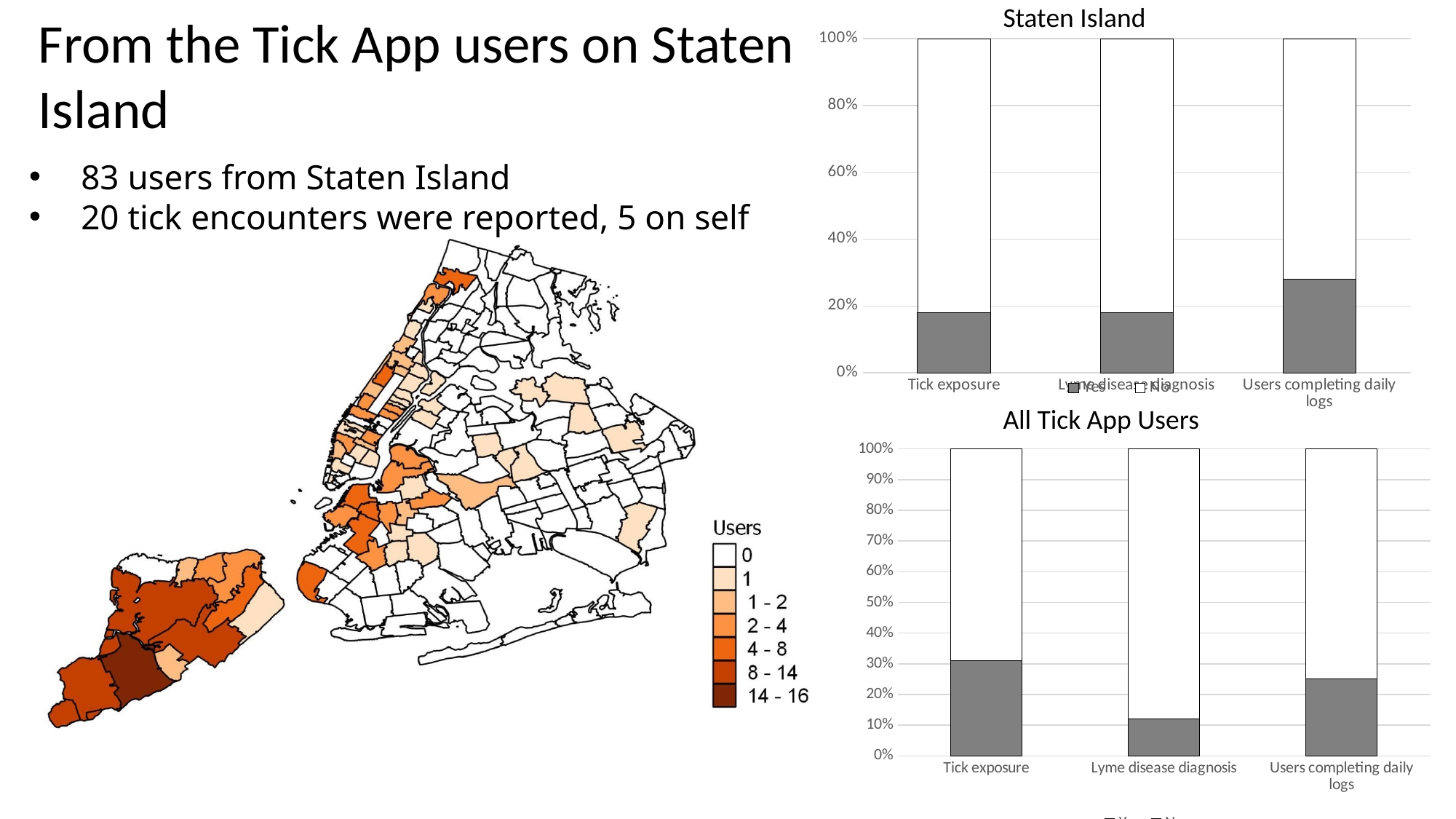
In the 'All Tick App Users' chart, which has a larger grey (Yes) portion: Tick exposure or Lyme disease diagnosis? Tick exposure What kind of chart is the 'Staten Island' chart? stacked bar chart In the 'All Tick App Users' chart, is the grey (Yes) portion for Lyme disease diagnosis greater or less than 20%? less In the 'Staten Island' chart, is the grey (Yes) portion for Users completing daily logs greater or less than 20%? greater In the 'All Tick App Users' chart, which category has the smallest grey (Yes) portion? Lyme disease diagnosis In the 'Staten Island' chart, what is the total height of each stacked bar? 100% How many categories are shown on the x axis of the 'All Tick App Users' chart? 3 In the 'All Tick App Users' chart, which category has the largest grey (Yes) portion? Tick exposure What is the title of the lower chart on the slide? All Tick App Users In the 'Staten Island' chart, which category has the largest grey (Yes) portion? Users completing daily logs In the 'Staten Island' chart, is the grey (Yes) portion for Tick exposure greater or less than 20%? less